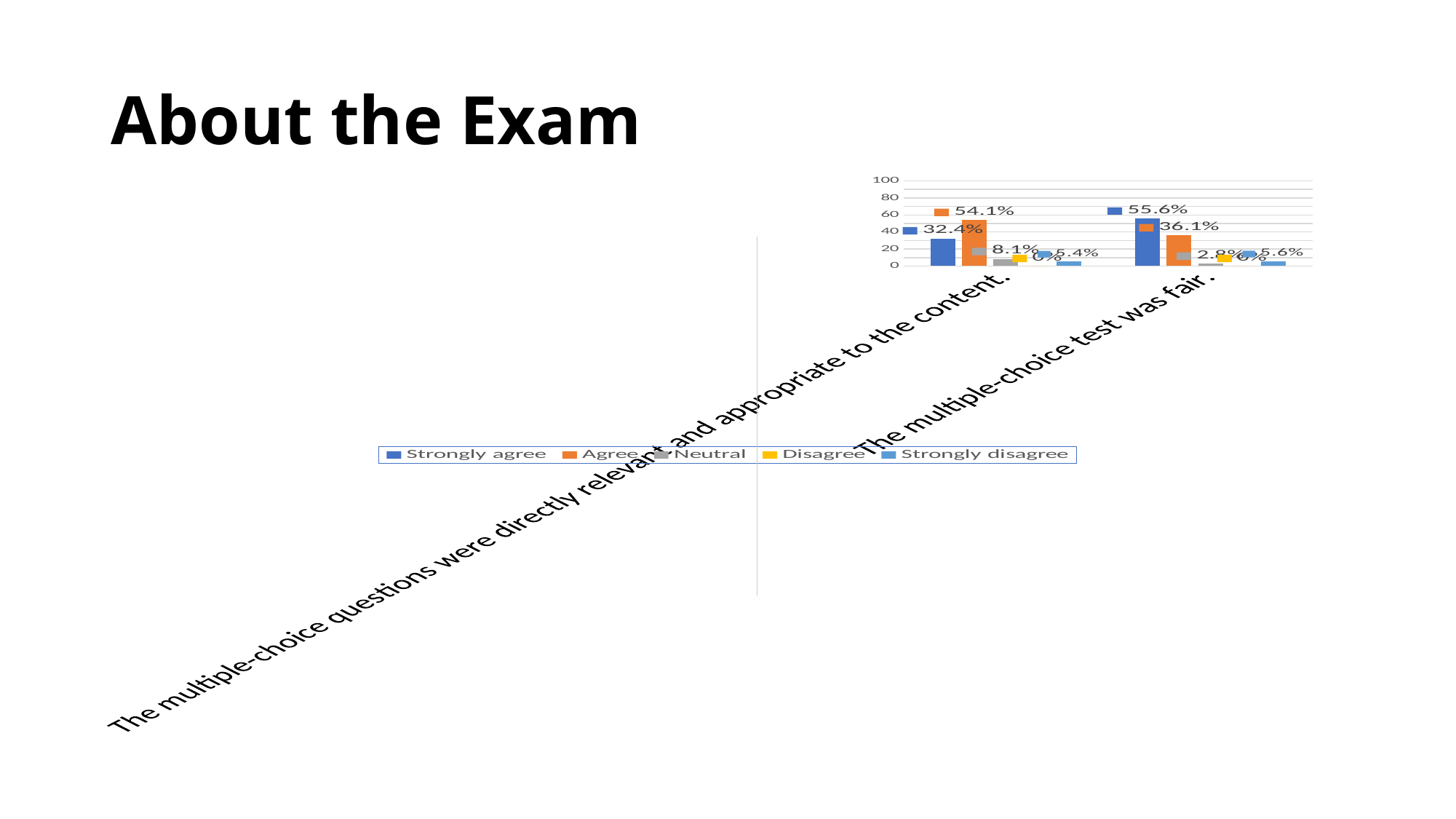
What is the difference between the Strongly agree values for "The multiple-choice test was fair." and "The multiple-choice questions were directly relevant and appropriate to the content."? 23.2% How many series does the legend list? 5 What kind of chart is shown on the slide? bar chart What is the value for Neutral for "The multiple-choice questions were directly relevant and appropriate to the content."? 8.1% Which series has the highest value for "The multiple-choice test was fair."? Strongly agree Which is larger: the Agree value for "The multiple-choice questions were directly relevant and appropriate to the content." or the Agree value for "The multiple-choice test was fair."? The multiple-choice questions were directly relevant and appropriate to the content. How many categories are plotted on the x axis? 2 What is the value for Strongly disagree for "The multiple-choice test was fair."? 5.6% What is the value for Disagree for "The multiple-choice test was fair."? 0% Which series has the highest value for "The multiple-choice questions were directly relevant and appropriate to the content."? Agree What is the value for Strongly agree for "The multiple-choice test was fair."? 55.6% What is the value for Agree for "The multiple-choice questions were directly relevant and appropriate to the content."? 54.1%